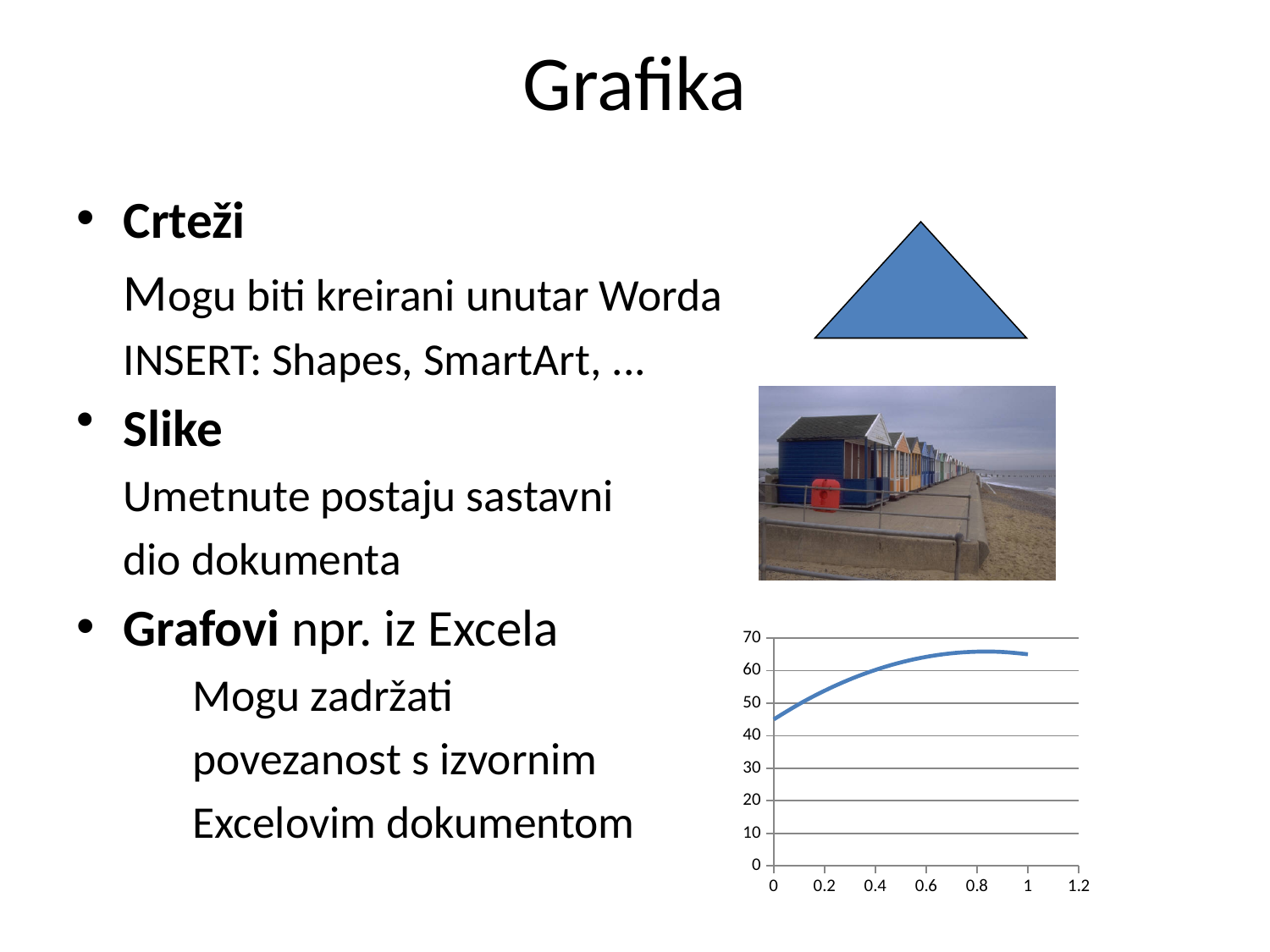
In the chart at the bottom right, is the value at x = 0.4 greater or less than 50? greater In the chart at the bottom right, does the line mainly rise or fall as x increases from 0 to 0.8? rise What kind of chart is shown at the bottom right of the slide? line chart In the chart at the bottom right, is the value at x = 0 greater or less than 50? less In the chart at the bottom right, is the value at x = 1 greater or less than 60? greater What is the highest value shown on the x axis of the chart at the bottom right? 1.2 In the chart at the bottom right, is the value at x = 1 larger or smaller than the value at x = 0? larger What is the highest value shown on the y axis of the chart at the bottom right? 70